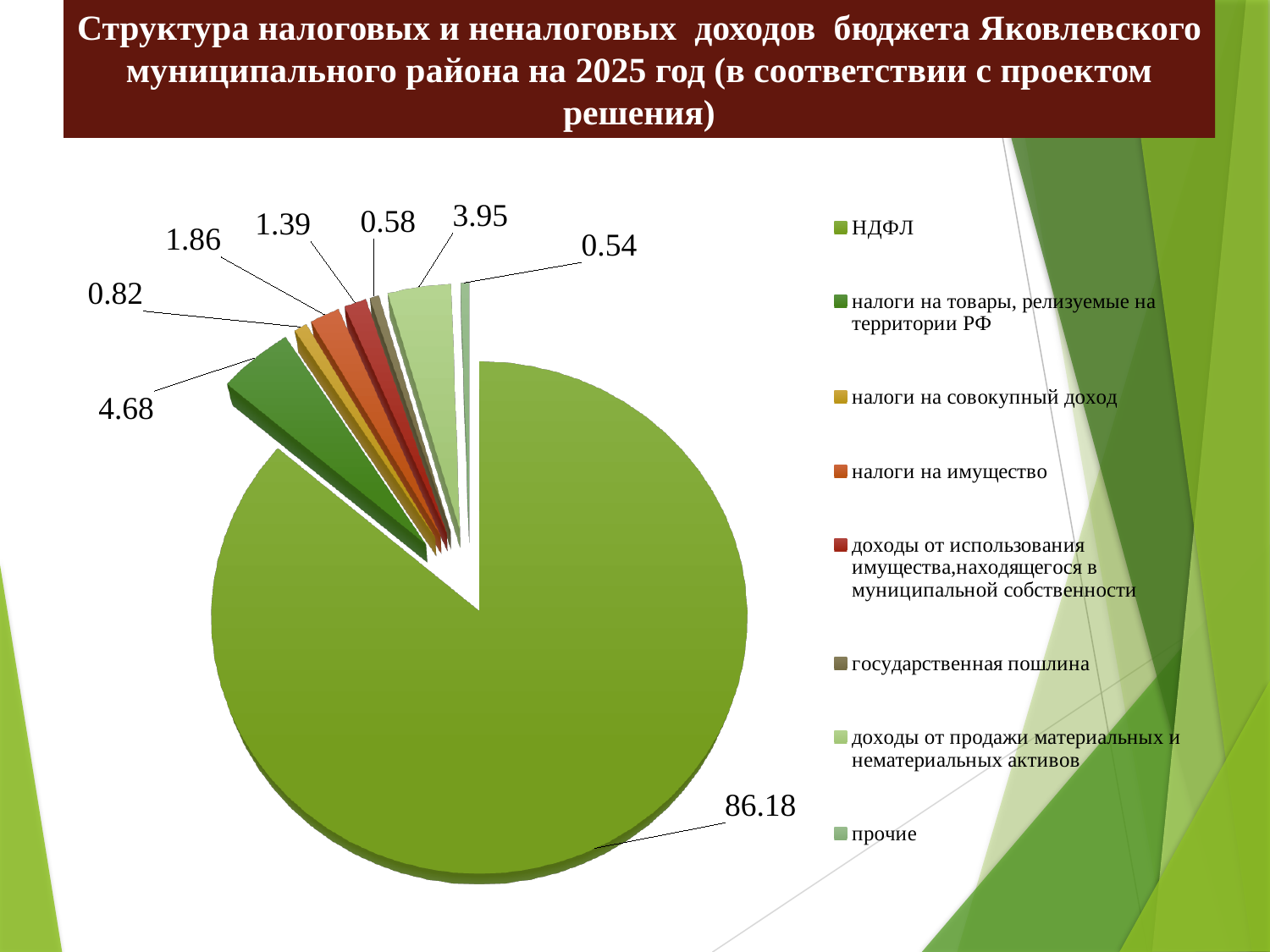
Which category has the smallest share of the pie? прочие Which category has the largest share of the pie? НДФЛ What is the difference between the values for налоги на имущество and налоги на совокупный доход? 1.04 How many slices does the pie chart have? 8 What is the value shown for прочие? 0.54 What kind of chart is shown on the slide? pie chart What is the value shown for НДФЛ? 86.18 Which is larger, the value for налоги на товары, реализуемые на территории РФ or the value for доходы от продажи материальных и нематериальных активов? налоги на товары, реализуемые на территории РФ How many entries does the legend list? 8 What is the value shown for налоги на товары, реализуемые на территории РФ? 4.68 What is the value shown for государственная пошлина? 0.58 What is the value shown for доходы от продажи материальных и нематериальных активов? 3.95